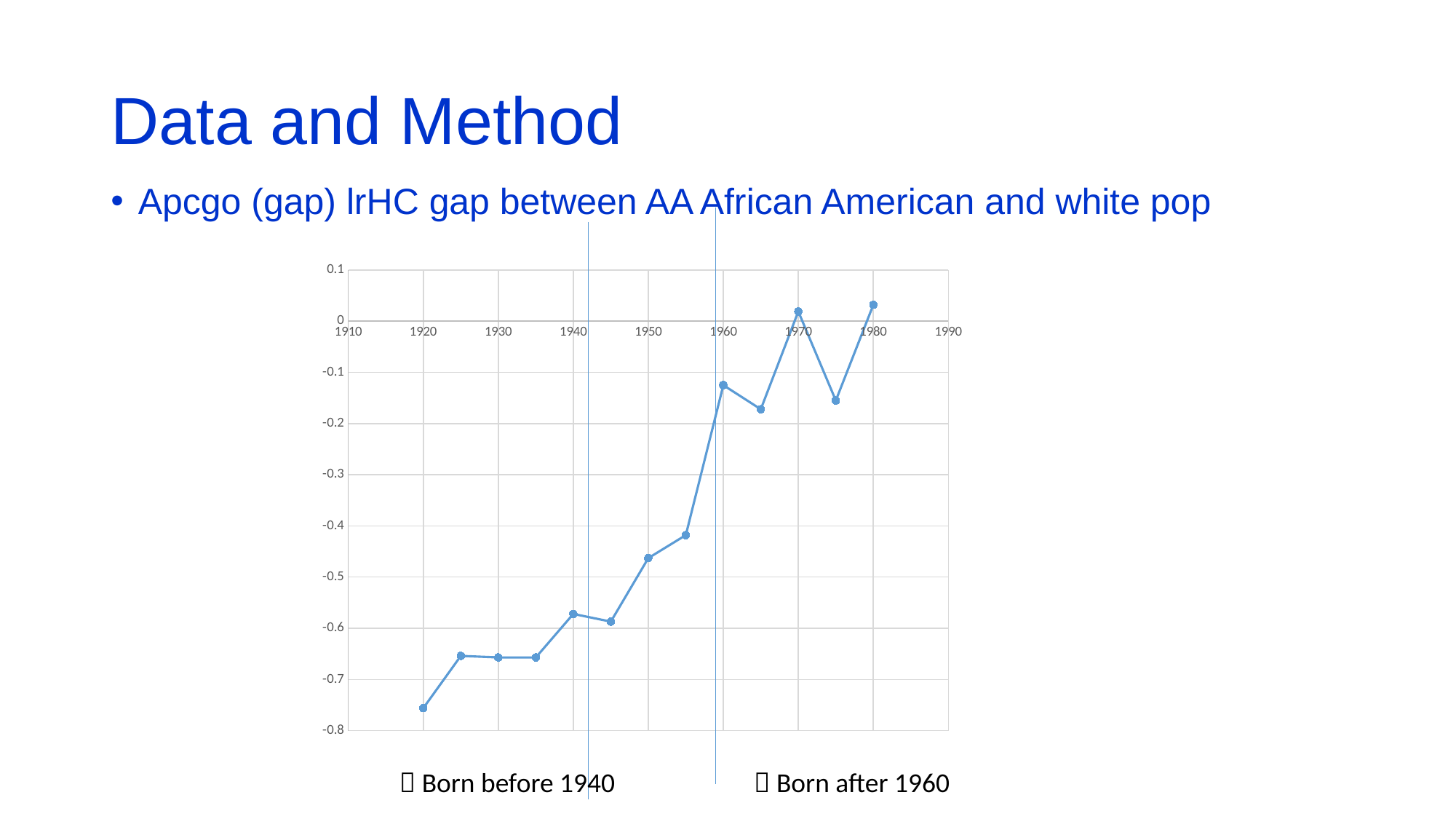
Is the value for 1920 greater or less than -0.7? less What kind of chart is shown on the slide? line chart Is the value for 1975 greater or less than -0.1? less How many data points are plotted on the line? 13 What is the lowest value shown on the vertical axis? -0.8 Which year has the lowest plotted value? 1920 Do the plotted values generally rise or fall from 1920 to 1980? rise What are the first and last years labelled on the horizontal axis? 1910 and 1990 Is the value for 1970 greater or less than 0? greater Which is larger, the value for 1955 or the value for 1960? 1960